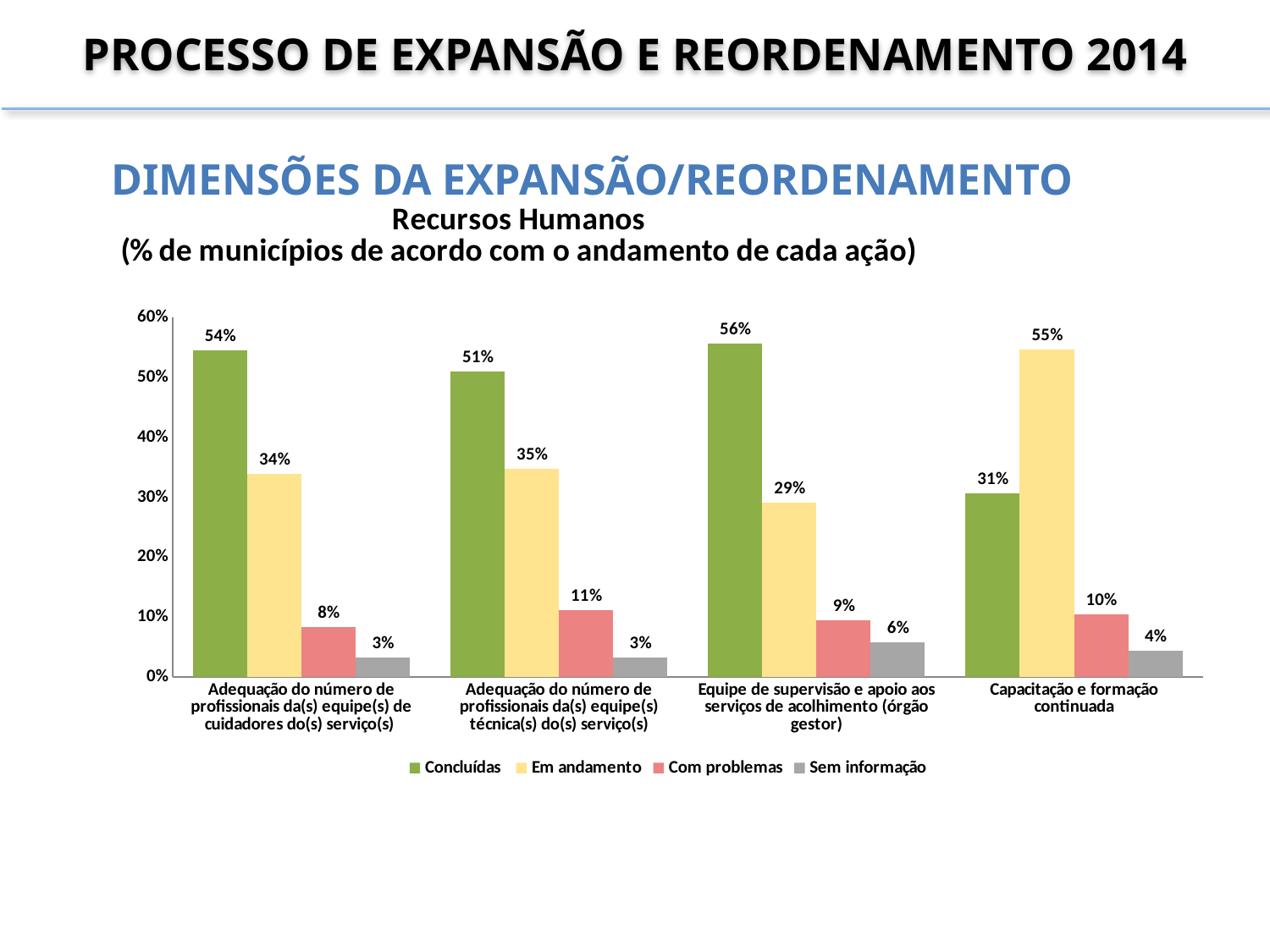
What is the value of 'Concluídas' for 'Capacitação e formação continuada'? 31% How many categories are shown on the x axis? 4 Which is larger for 'Adequação do número de profissionais da(s) equipe(s) de cuidadores do(s) serviço(s)': 'Concluídas' or 'Em andamento'? Concluídas What is the value of 'Em andamento' for 'Equipe de supervisão e apoio aos serviços de acolhimento (órgão gestor)'? 29% Is the 'Em andamento' value for 'Capacitação e formação continuada' greater or less than 50%? greater Which category has the lowest 'Em andamento' value? Equipe de supervisão e apoio aos serviços de acolhimento (órgão gestor) Which category has the highest 'Concluídas' value? Equipe de supervisão e apoio aos serviços de acolhimento (órgão gestor) How many series does the legend list? 4 Which series is shown in green in the legend? Concluídas What kind of chart is shown on the slide? Bar chart What is the difference between the 'Concluídas' and 'Em andamento' values for 'Capacitação e formação continuada'? 24% What is the value of 'Com problemas' for 'Adequação do número de profissionais da(s) equipe(s) técnica(s) do(s) serviço(s)'? 11%